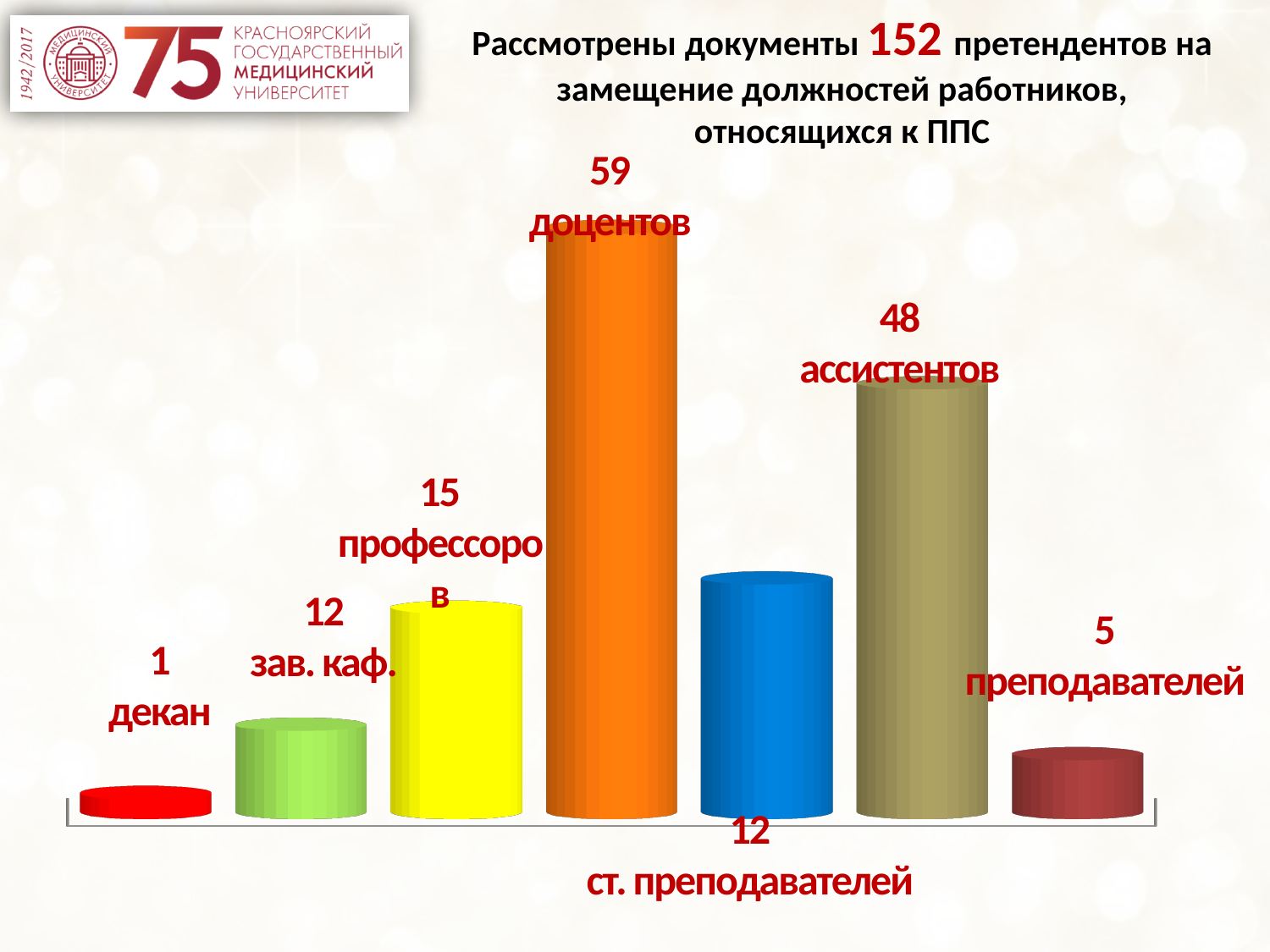
What is the difference between the values for доцентов and ассистентов? 11 What type of chart is shown on the slide? bar chart What is the value for декан? 1 Which category has the lowest value? декан Which category has the highest value? доцентов What is the value for преподавателей? 5 Which is larger, the value for ассистентов or the value for профессоров? ассистентов What is the value for доцентов? 59 What total number of applicants is stated in the slide title? 152 What is the value for ассистентов? 48 What is the value for профессоров? 15 How many categories are shown in the chart? 7